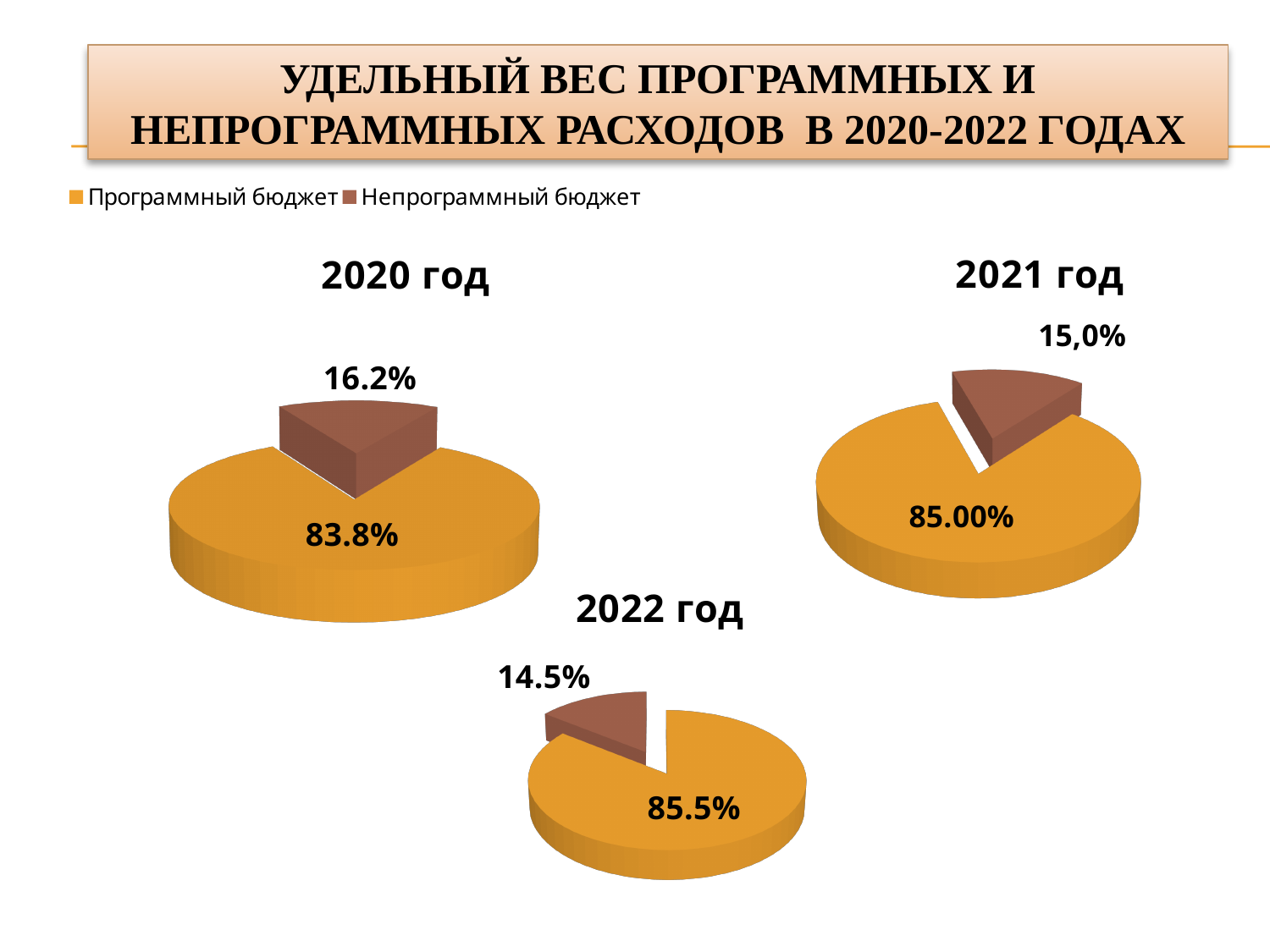
На диаграмме «2020 год» на сколько процентных пунктов доля программного бюджета больше доли непрограммного? 67.6 Сколько круговых диаграмм показано на слайде? 3 На диаграмме «2022 год» какая категория занимает наименьшую долю? Непрограммный бюджет На диаграмме «2022 год» какова доля программного бюджета? 85.5% На диаграмме «2020 год» какова доля непрограммного бюджета? 16.2% Какой тип диаграмм используется на слайде? Круговая диаграмма На диаграмме «2021 год» какова доля непрограммного бюджета? 15,0% На диаграмме «2020 год» какова доля программного бюджета? 83.8% На диаграмме «2021 год» какова доля программного бюджета? 85.00% Сколько категорий перечислено в легенде слайда? 2 На диаграмме «2022 год» какова доля непрограммного бюджета? 14.5% На диаграмме «2020 год» какая категория занимает наибольшую долю? Программный бюджет